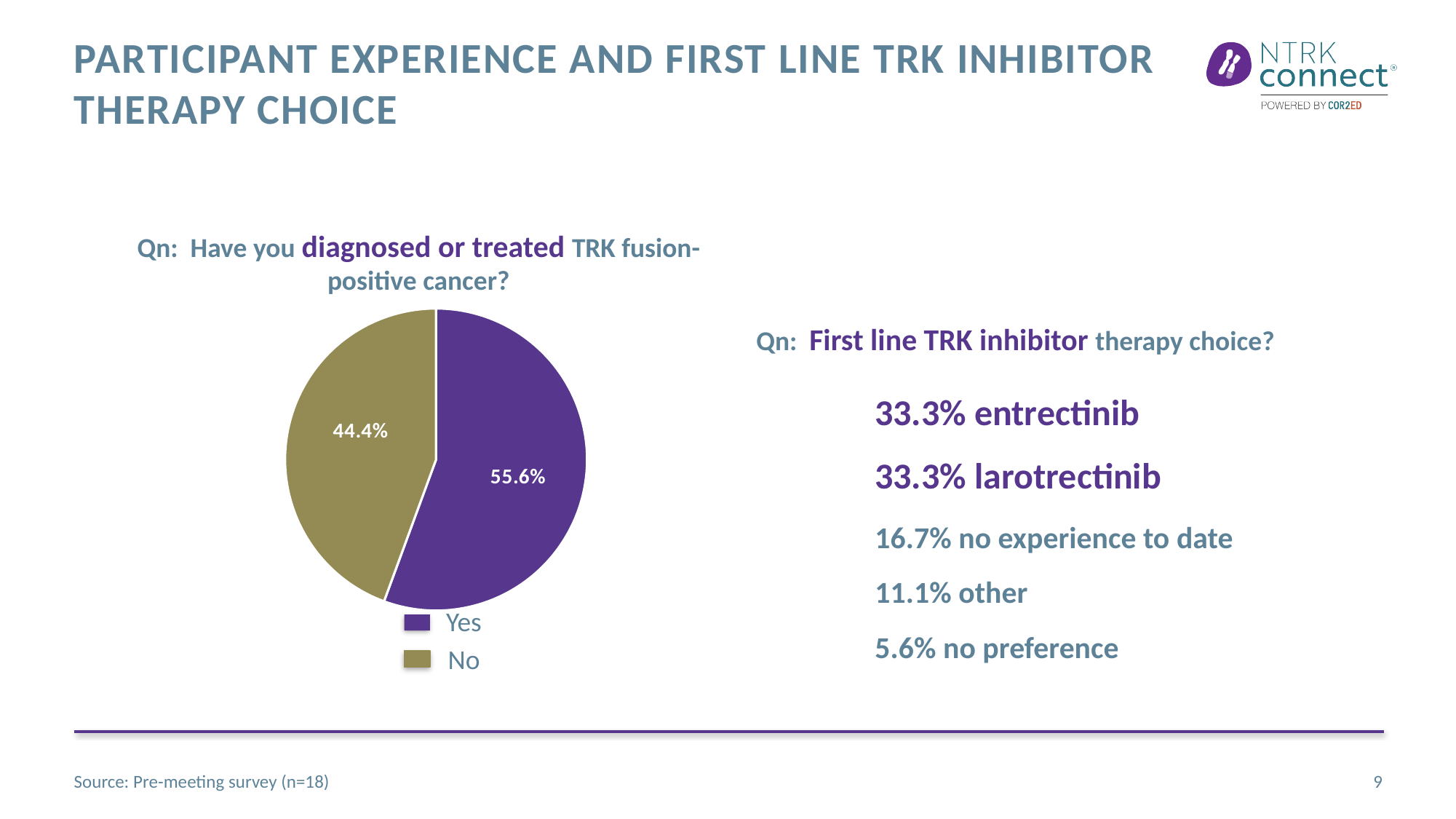
What question does the pie chart answer? Have you diagnosed or treated TRK fusion-positive cancer? Is the share of the "No" slice in the pie chart greater or less than 50%? less What share of the pie chart is labelled "No"? 44.4% What is the difference in percentage points between the Yes and No slices of the pie chart? 11.2 How many entries does the pie chart legend list? 2 What colour is the "Yes" slice in the pie chart? purple Which slice of the pie chart is larger, Yes or No? Yes How many slices does the pie chart have? 2 What share of the pie chart is labelled "Yes"? 55.6% Which category has the smallest slice in the pie chart? No What kind of chart is shown on the slide? pie chart